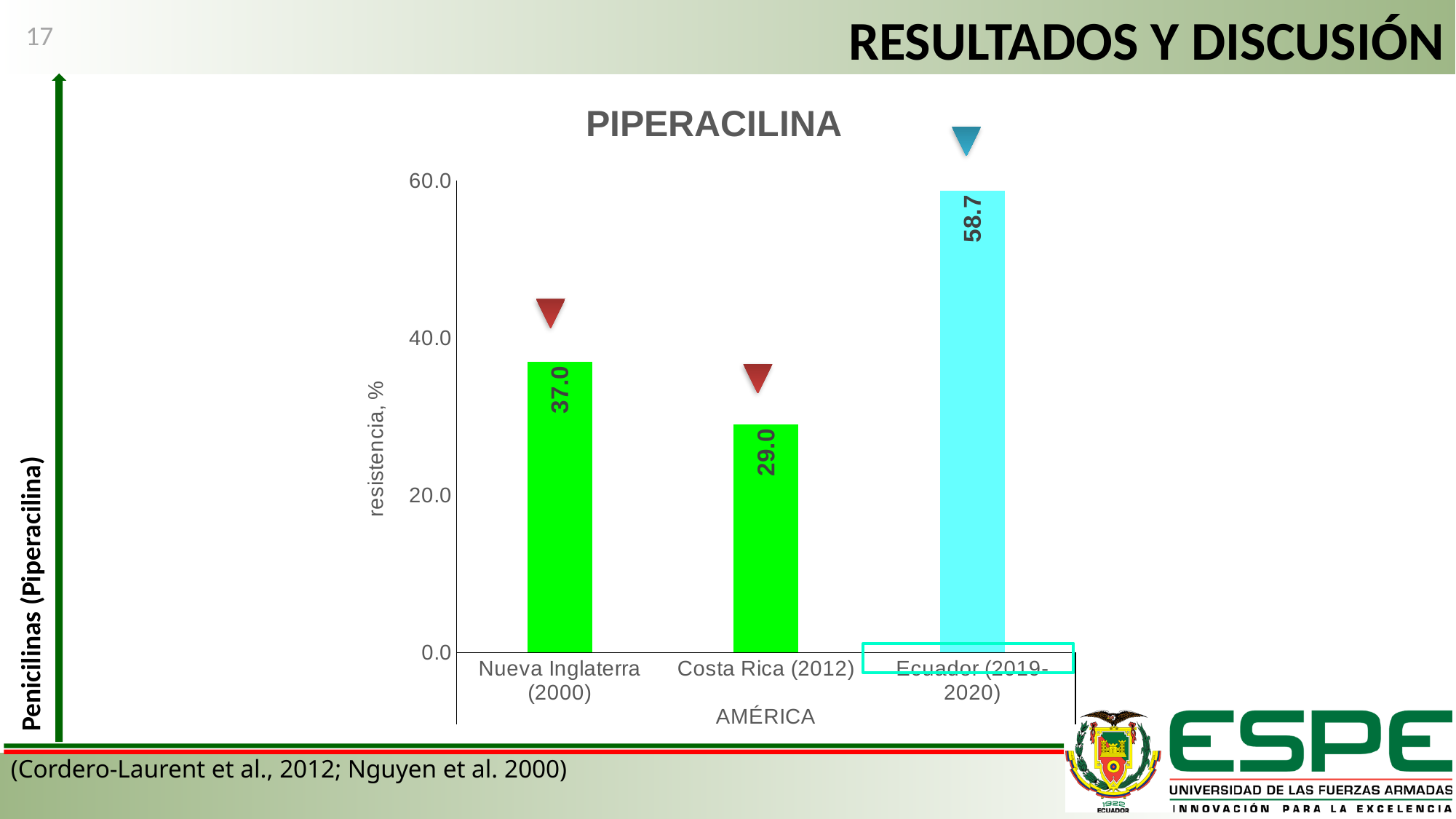
What is the difference between the resistance values for Nueva Inglaterra (2000) and Costa Rica (2012)? 8.0 What is the title of the chart? PIPERACILINA How many categories are shown on the x axis? 3 What kind of chart is shown on the slide? bar chart Which category has the highest resistance value? Ecuador (2019-2020) What is the resistance value for Ecuador (2019-2020)? 58.7 Which has a larger resistance value, Nueva Inglaterra (2000) or Costa Rica (2012)? Nueva Inglaterra (2000) Is the value for Ecuador (2019-2020) greater or less than 40.0? greater What is the difference between the resistance values for Ecuador (2019-2020) and Nueva Inglaterra (2000)? 21.7 Which category has the lowest resistance value? Costa Rica (2012) What is the resistance value for Costa Rica (2012)? 29.0 What is the resistance value for Nueva Inglaterra (2000)? 37.0